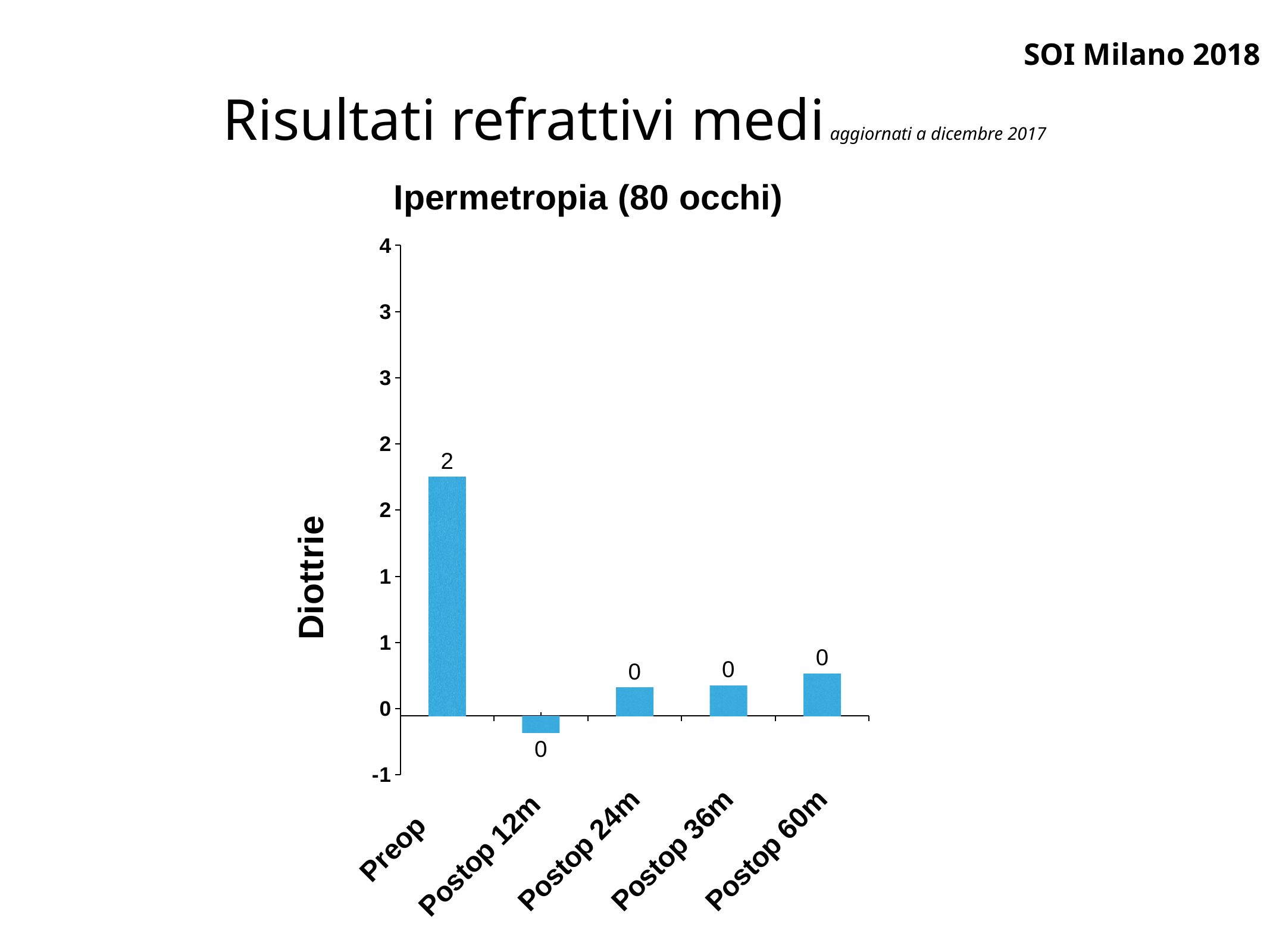
What is the data label shown on the Postop 60m bar? 0 Which category has the highest value? Preop What is the label of the vertical axis? Diottrie Is the value for Postop 12m greater or less than 0? less How many categories are shown on the x axis? 5 Is the value for Preop greater or less than 1? greater What kind of chart is shown on the slide? Bar chart Using the printed data labels, what is the difference between the Preop value and the Postop 24m value? 2 What is the data label shown on the Preop bar? 2 Which category has the lowest value? Postop 12m Which is larger, the value for Preop or the value for Postop 36m? Preop What is the title of the chart? Ipermetropia (80 occhi)